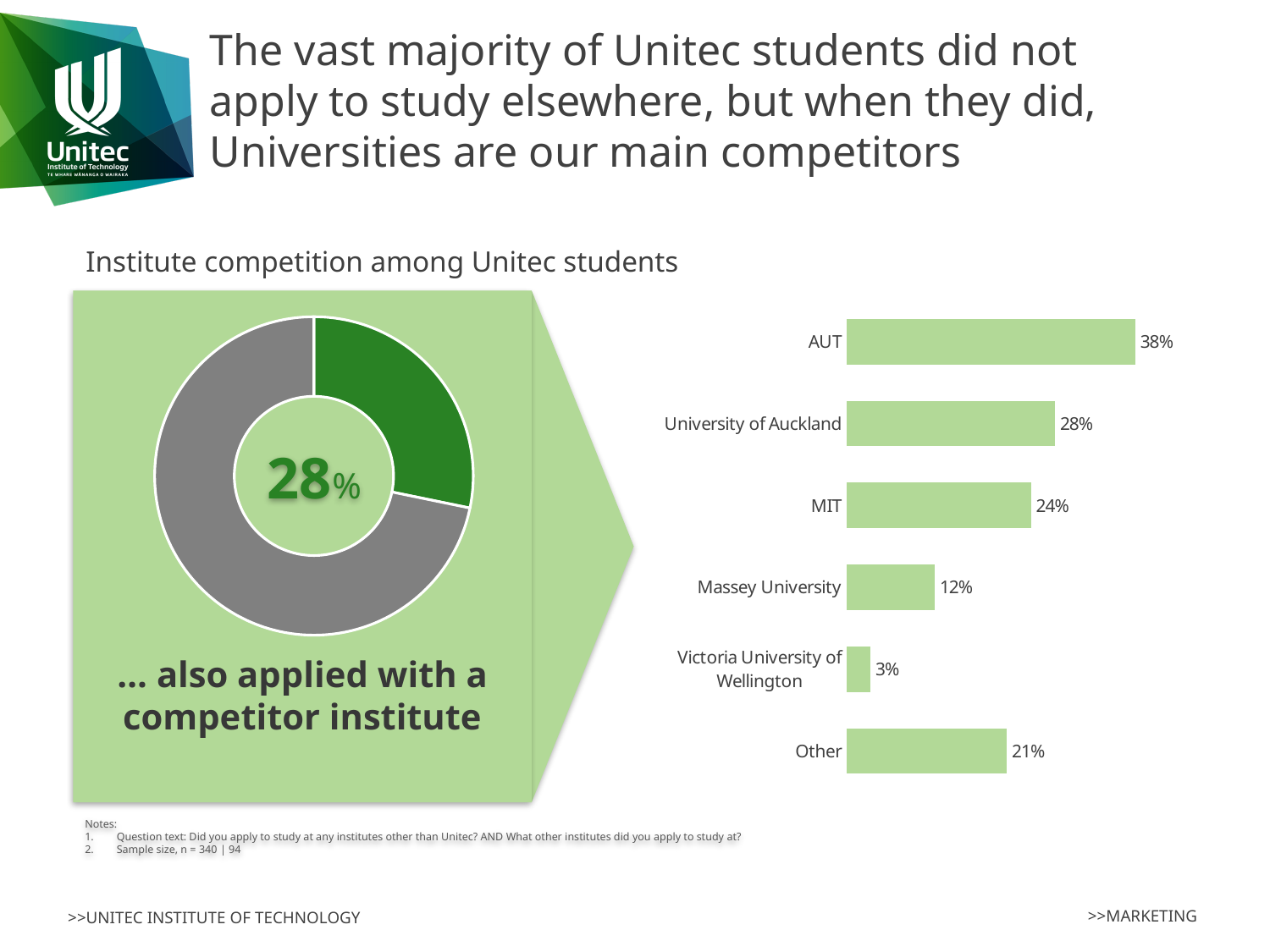
In the bar chart on the right, what is the value for AUT? 38% In the donut chart on the left, what percentage of Unitec students also applied with a competitor institute? 28% What kind of chart is shown on the left side of the slide? Donut chart What kind of chart is shown on the right side of the slide? Bar chart How many institutes are shown in the bar chart on the right? 6 In the bar chart on the right, which institute has the highest value? AUT In the bar chart on the right, what is the value for Victoria University of Wellington? 3% In the bar chart on the right, what is the difference between the values for AUT and MIT? 14% In the bar chart on the right, which is larger, the value for Massey University or the value for Other? Other In the bar chart on the right, which institute has the lowest value? Victoria University of Wellington In the bar chart on the right, what is the value for University of Auckland? 28% In the bar chart on the right, what is the value for Other? 21%